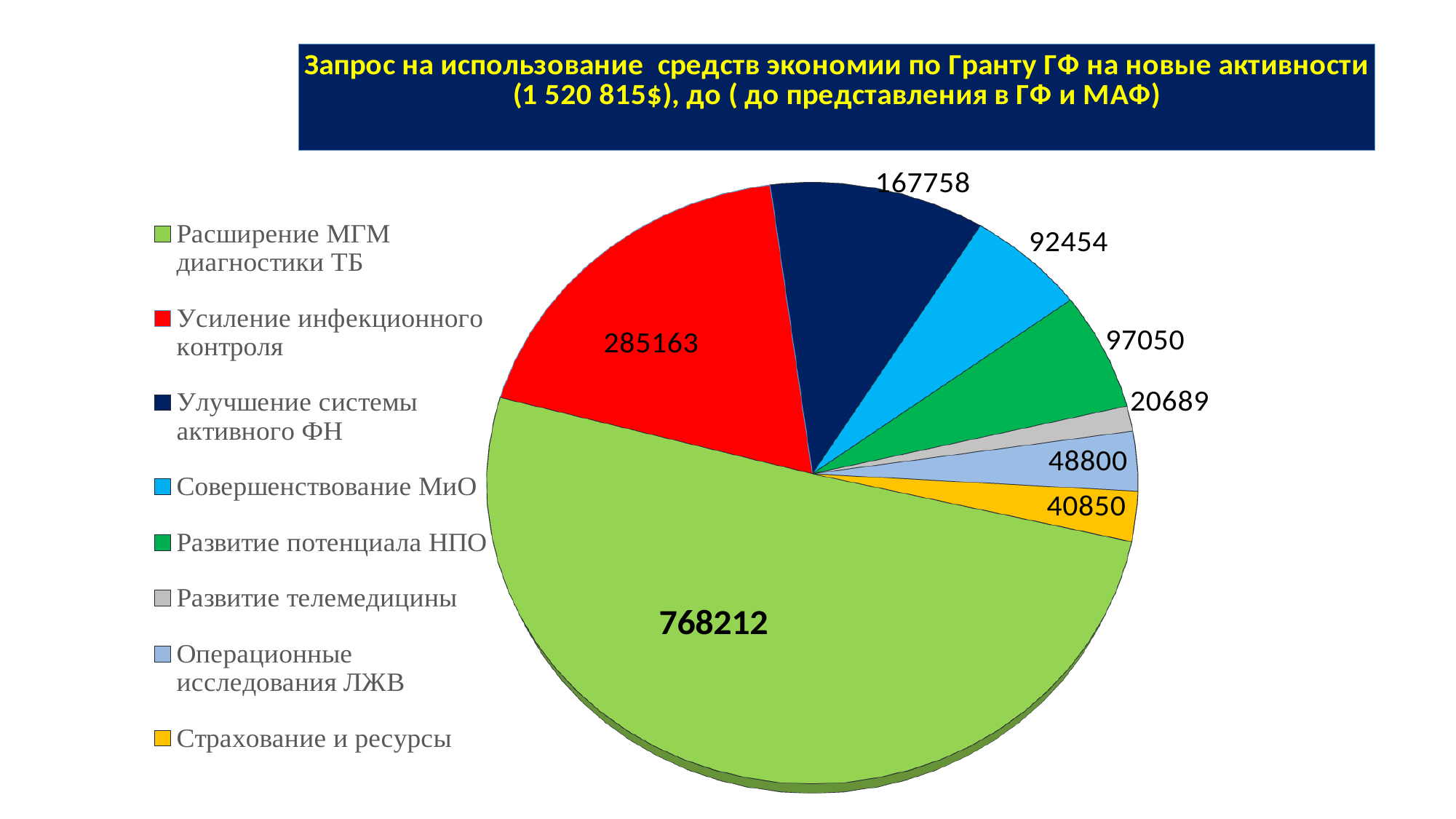
What kind of chart is shown on the slide? Pie chart What is the value for Развитие телемедицины? 20689 What colour is the slice for Усиление инфекционного контроля? Red What is the value for Страхование и ресурсы? 40850 How many categories does the pie chart show? 8 What is the value for Улучшение системы активного ФН? 167758 What is the value for Расширение МГМ диагностики ТБ? 768212 What is the difference between the values for Усиление инфекционного контроля and Улучшение системы активного ФН? 117405 Which category has the largest slice of the pie? Расширение МГМ диагностики ТБ Which is larger: Операционные исследования ЛЖВ or Страхование и ресурсы? Операционные исследования ЛЖВ What is the value for Усиление инфекционного контроля? 285163 Which category has the smallest slice of the pie? Развитие телемедицины